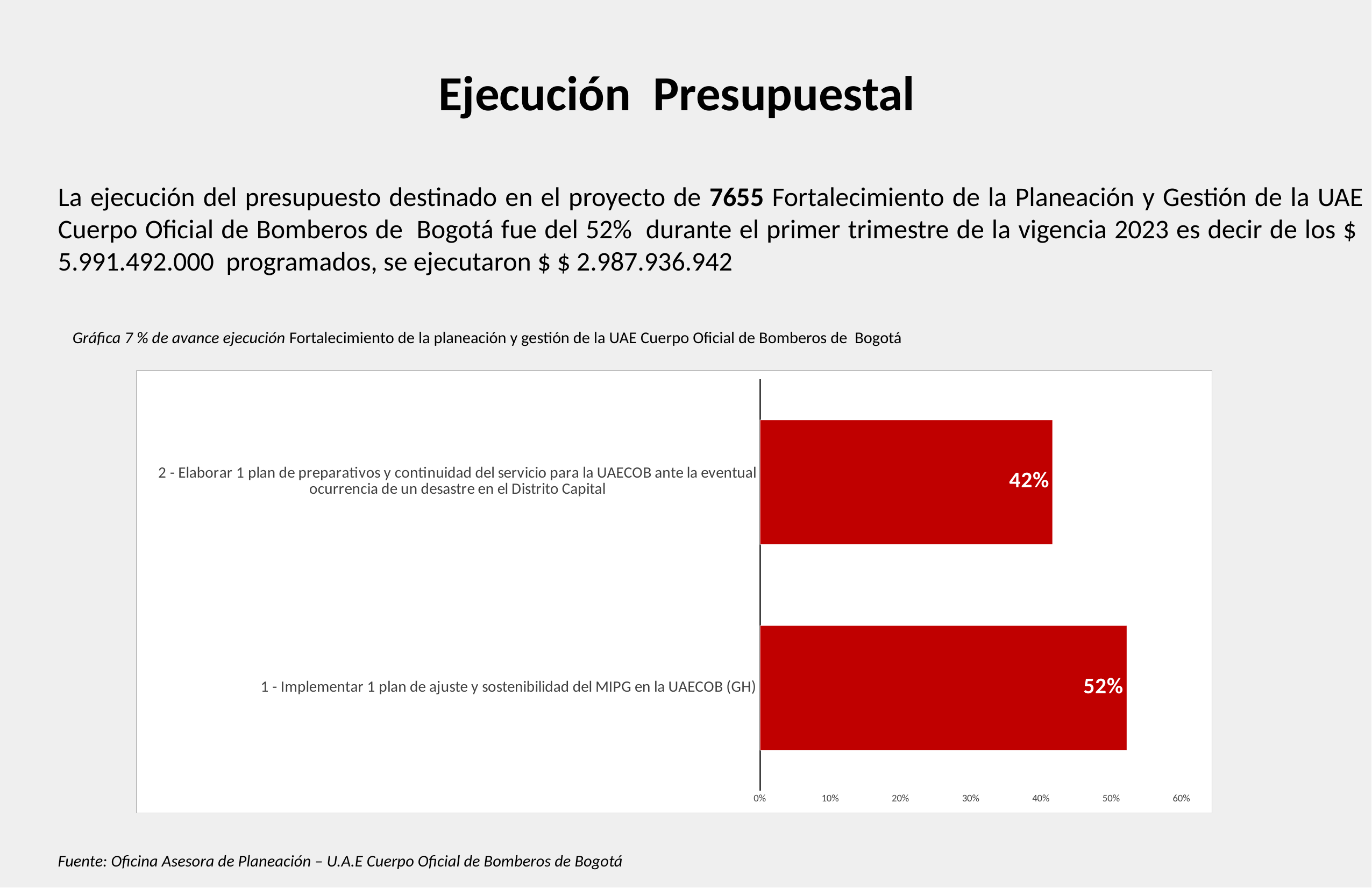
What is the difference between the value for goal 1 (Implementar 1 plan de ajuste y sostenibilidad del MIPG) and goal 2 (Elaborar 1 plan de preparativos y continuidad del servicio)? 10% Which category has the highest value? 1 - Implementar 1 plan de ajuste y sostenibilidad del MIPG en la UAECOB (GH) Is the value for '1 - Implementar 1 plan de ajuste y sostenibilidad del MIPG en la UAECOB (GH)' greater or less than 40%? greater Is the value for '2 - Elaborar 1 plan de preparativos y continuidad del servicio' greater or less than 50%? less What kind of chart is shown on the slide? Bar chart How many categories (bars) are shown in the chart? 2 What is the value for '1 - Implementar 1 plan de ajuste y sostenibilidad del MIPG en la UAECOB (GH)'? 52% What is the maximum value shown on the horizontal axis of the chart? 60% Which category has the lowest value? 2 - Elaborar 1 plan de preparativos y continuidad del servicio para la UAECOB ante la eventual ocurrencia de un desastre en el Distrito Capital Which is larger: the value for goal 1 (Implementar 1 plan de ajuste y sostenibilidad del MIPG) or goal 2 (Elaborar 1 plan de preparativos y continuidad del servicio)? Goal 1 (Implementar 1 plan de ajuste y sostenibilidad del MIPG) What colour are the bars in the chart? Red What is the value for '2 - Elaborar 1 plan de preparativos y continuidad del servicio para la UAECOB ante la eventual ocurrencia de un desastre en el Distrito Capital'? 42%